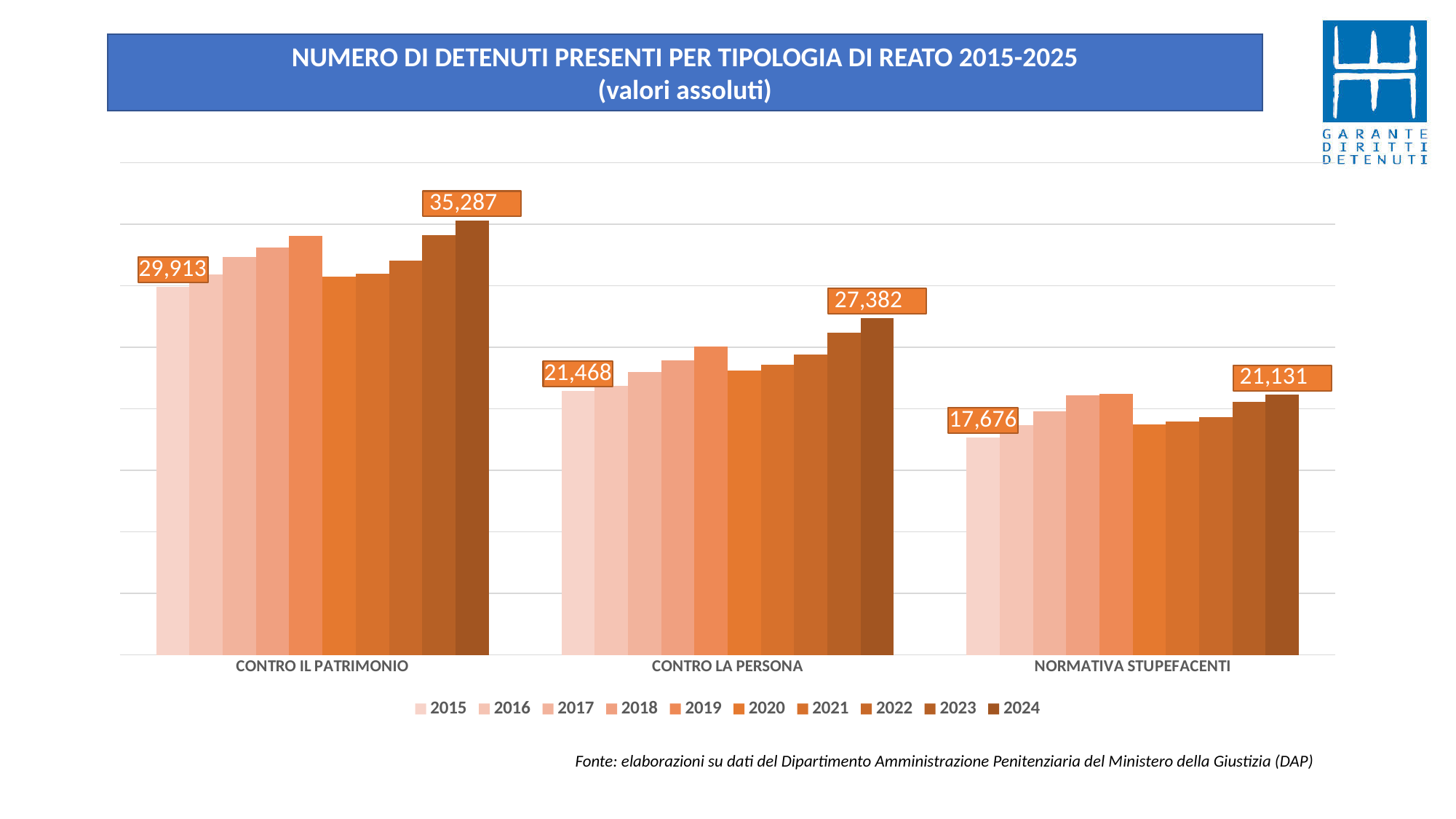
Which offence category has the lowest value in 2015? NORMATIVA STUPEFACENTI What is the value for NORMATIVA STUPEFACENTI in 2015? 17,676 What is the value for CONTRO IL PATRIMONIO in 2015? 29,913 Which offence category has the highest value in 2024? CONTRO IL PATRIMONIO What is the value for CONTRO LA PERSONA in 2024? 27,382 How many years does the legend list? 10 What is the value for CONTRO IL PATRIMONIO in 2024? 35,287 Which is larger: the 2024 value for NORMATIVA STUPEFACENTI or the 2015 value for CONTRO LA PERSONA? 2015 value for CONTRO LA PERSONA What kind of chart is shown on the slide? Bar chart How many offence categories are shown on the x axis? 3 What is the title of the chart? NUMERO DI DETENUTI PRESENTI PER TIPOLOGIA DI REATO 2015-2025 (valori assoluti) What is the difference between the 2024 and 2015 values for CONTRO LA PERSONA? 5,914